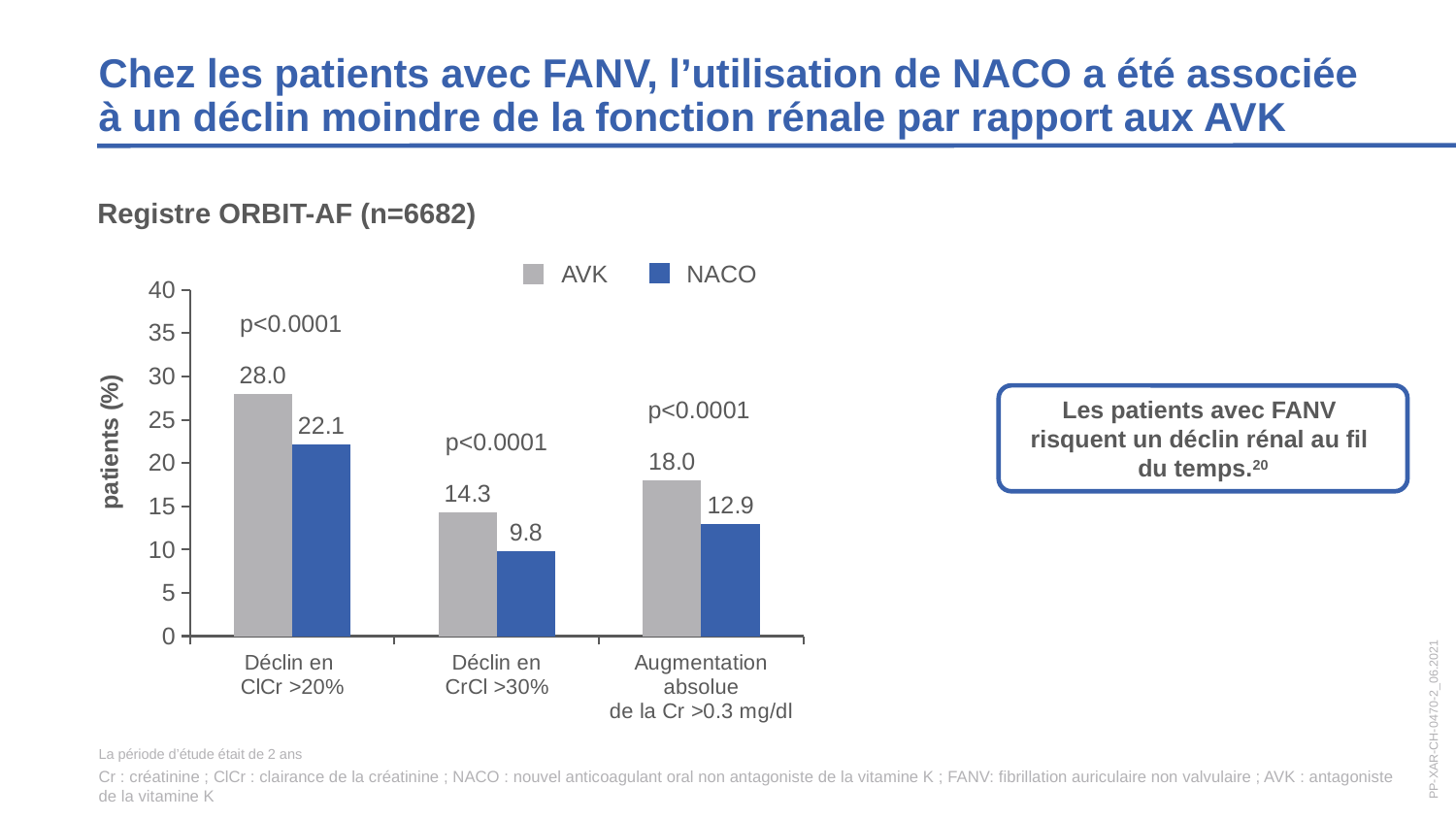
What is the difference between the AVK and NACO values in the 'Déclin en ClCr >20%' category? 5.9 What is the difference between the AVK and NACO values in the 'Augmentation absolue de la Cr >0.3 mg/dl' category? 5.1 Which category has the highest AVK value? Déclin en ClCr >20% What is the value for AVK in the 'Déclin en ClCr >20%' category? 28.0 Which category has the lowest NACO value? Déclin en CrCl >30% Is the NACO value for 'Déclin en ClCr >20%' greater or less than 20? greater Which is larger in the 'Déclin en CrCl >30%' category, AVK or NACO? AVK How many categories are shown on the x axis? 3 What is the value for NACO in the 'Déclin en CrCl >30%' category? 9.8 How many series does the legend list? 2 What kind of chart is shown on the slide? Bar chart What is the value for NACO in the 'Augmentation absolue de la Cr >0.3 mg/dl' category? 12.9